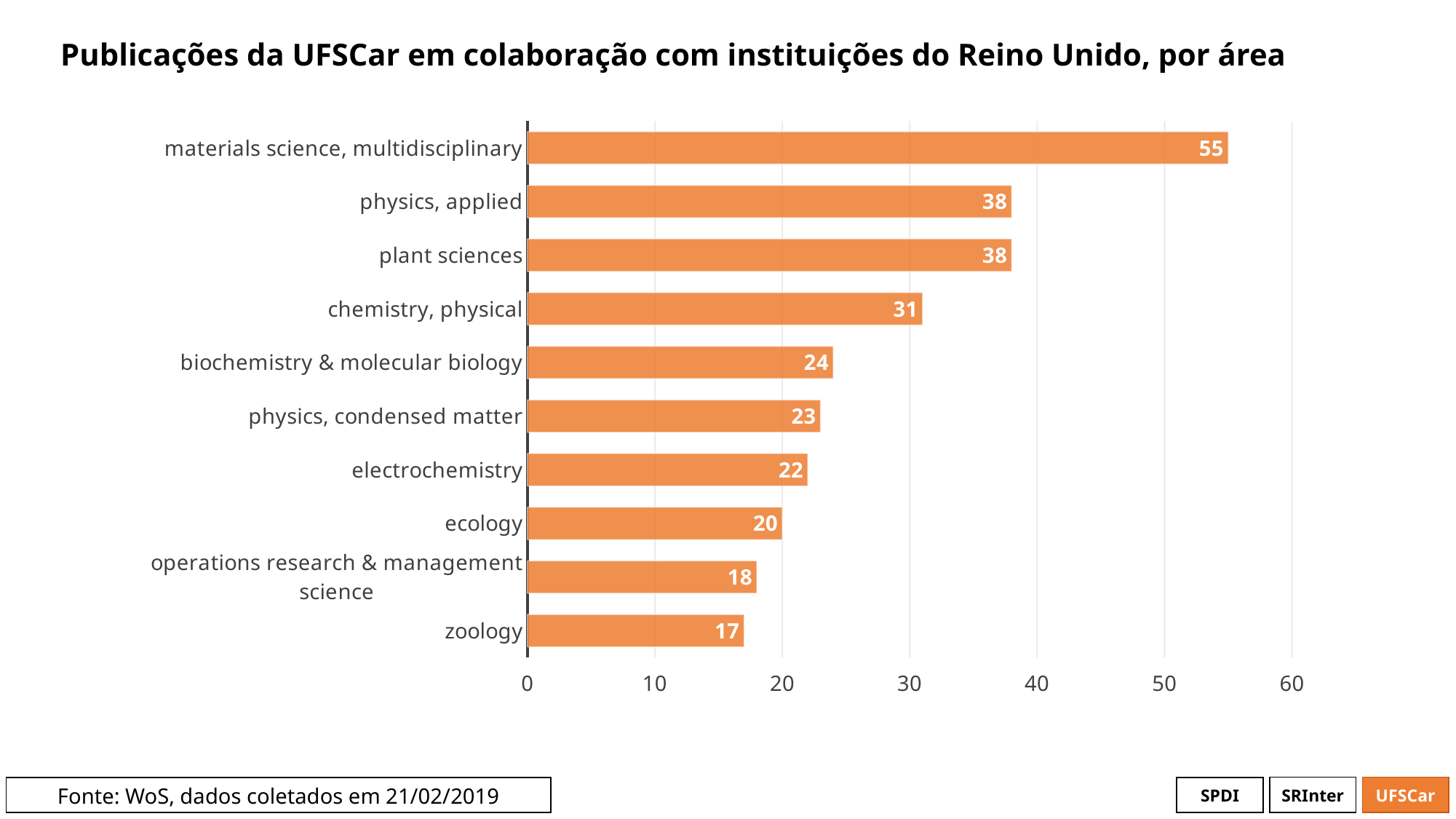
What is the value for chemistry, physical? 31 Which area has the lowest number of publications? zoology What is the value for operations research & management science? 18 How many publications are shown for materials science, multidisciplinary? 55 How many areas are shown in the chart? 10 What is the title of the chart? Publicações da UFSCar em colaboração com instituições do Reino Unido, por área Which area has the highest number of publications? materials science, multidisciplinary What is the difference between biochemistry & molecular biology and ecology? 4 Is the value for plant sciences greater or less than 30? greater What kind of chart is shown on the slide? bar chart What is the difference between materials science, multidisciplinary and physics, applied? 17 Which is larger, the value for electrochemistry or the value for zoology? electrochemistry